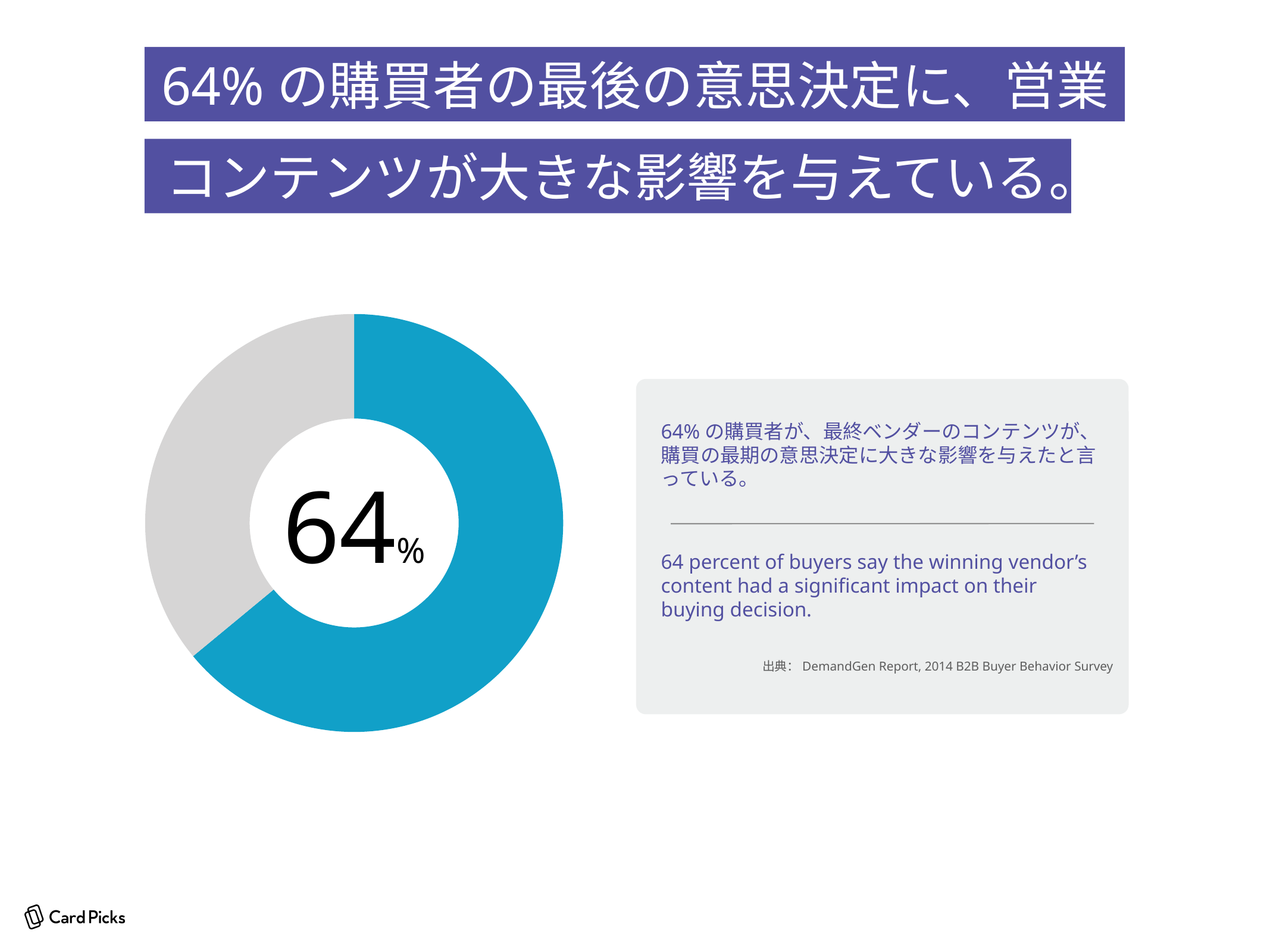
According to the slide, what is the source of the data shown in the chart? DemandGen Report, 2014 B2B Buyer Behavior Survey What share of the donut chart does the blue segment represent? 64% Is the blue segment of the donut chart greater or less than 50% of the whole? greater Which segment of the donut chart is larger, the blue one or the grey one? The blue one What kind of chart is shown on the slide? Donut (pie) chart Is the grey segment of the donut chart greater or less than 50% of the whole? less What colour is the segment representing the 64% of buyers in the donut chart? Blue How many segments does the donut chart have? 2 What percentage is printed in the centre of the donut chart? 64%